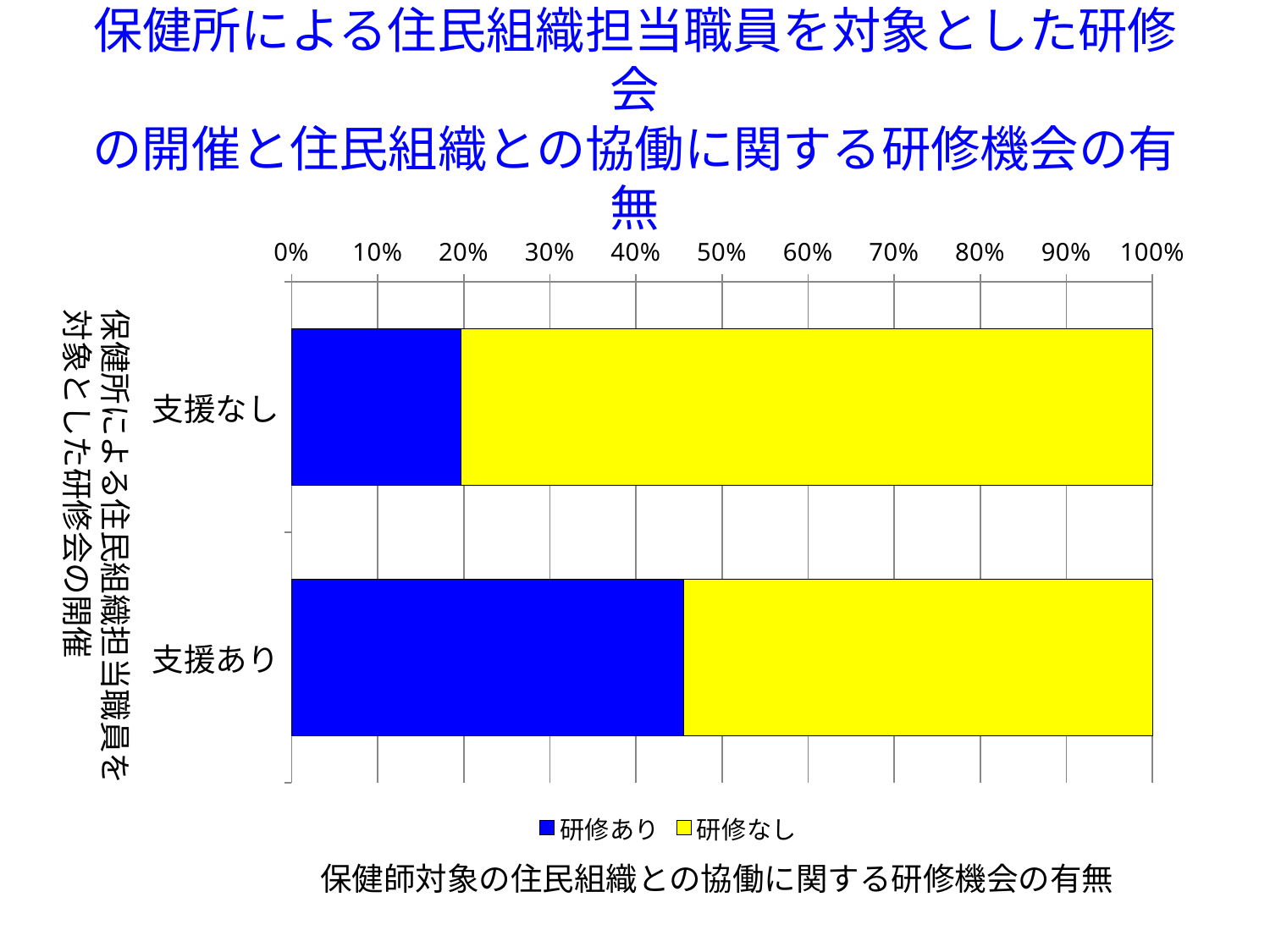
Is the 研修あり share for 支援なし greater or less than 30%? less Is the 研修あり share for 支援あり greater or less than 40%? greater How many categories are shown on the vertical axis of the chart? 2 What kind of chart is shown on the slide? bar chart How many series does the legend list? 2 Which category has the lowest 研修あり share? 支援なし Is the 研修なし share for 支援なし greater or less than 70%? greater Which series is shown in yellow in the chart? 研修なし Which category has the larger 研修あり share, 支援あり or 支援なし? 支援あり Which series is shown in blue in the chart? 研修あり Which category has the highest 研修なし share? 支援なし